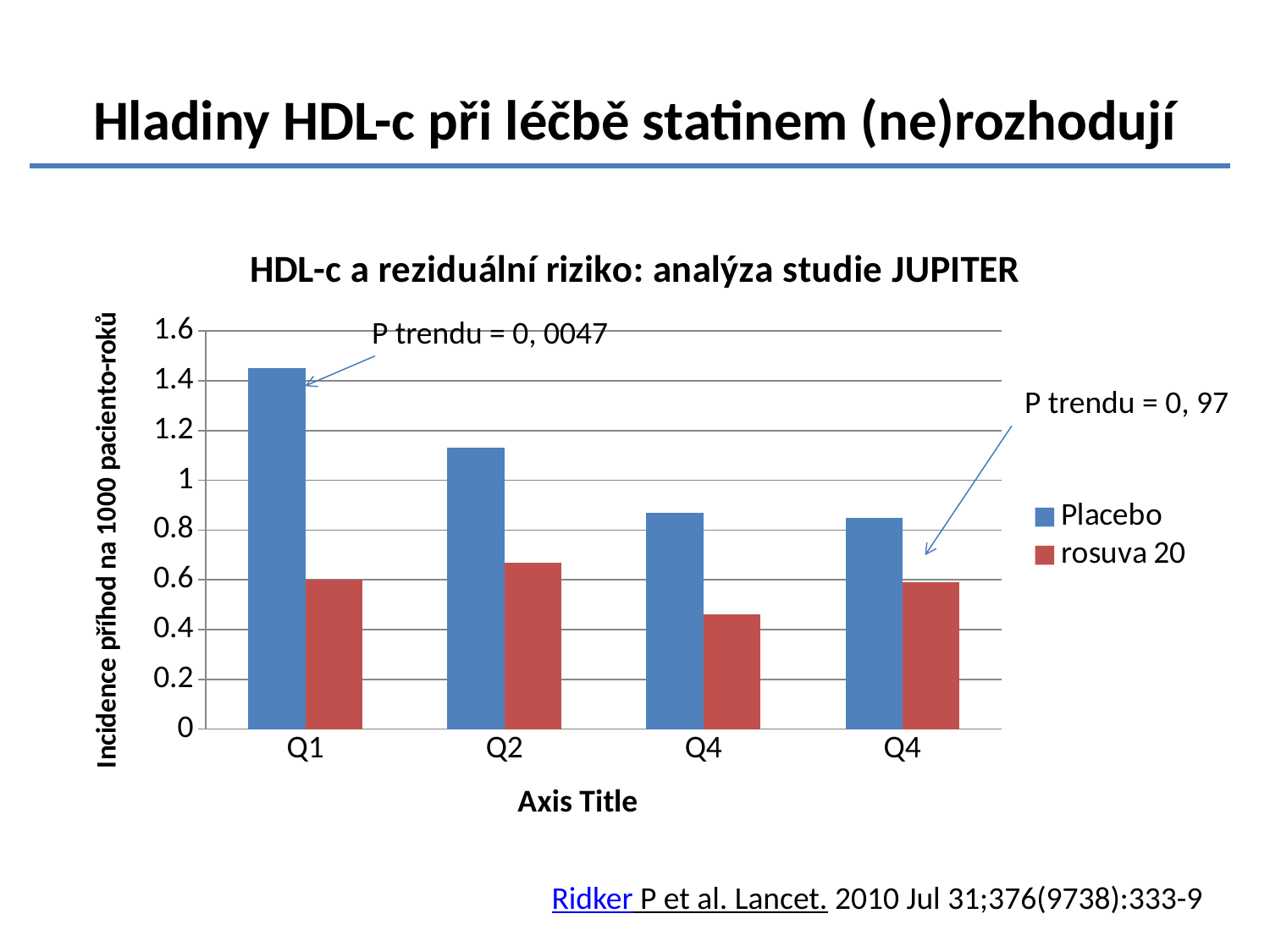
For which category is the rosuva 20 value highest? Q2 Is the rosuva 20 value for Q1 greater or less than 0.8? less At Q1, which series has the larger value, Placebo or rosuva 20? Placebo How many series does the legend list? 2 Is the Placebo value for Q1 greater or less than 1.2? greater Is the Placebo value for Q2 greater or less than 1? greater What are the two series named in the legend? Placebo and rosuva 20 What kind of chart is shown on the slide? bar chart Do the Placebo values rise or fall from left to right along the x axis? fall How many categories are shown on the x axis? 4 For which category is the Placebo value highest? Q1 What is the title of the chart? HDL-c a reziduální riziko: analýza studie JUPITER